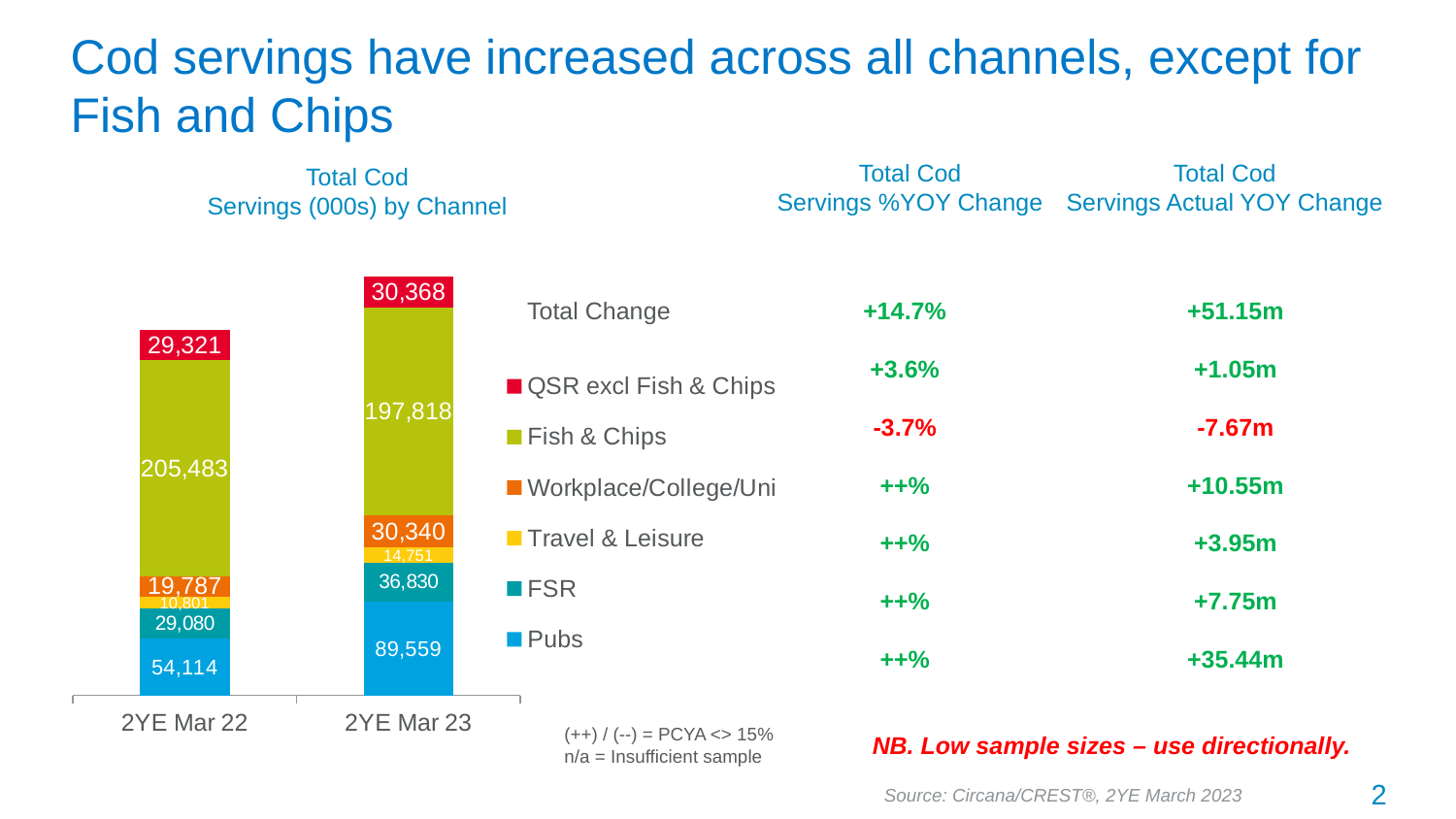
Which channel has the largest segment in the 2YE Mar 23 bar? Fish & Chips What is the value for Workplace/College/Uni in 2YE Mar 23? 30,340 How many series does the chart legend list? 6 Which channel has the smallest segment in the 2YE Mar 22 bar? Travel & Leisure Which is larger: Fish & Chips in 2YE Mar 22 or Fish & Chips in 2YE Mar 23? 2YE Mar 22 What is the value for Pubs in 2YE Mar 23? 89,559 How many bars (periods) are plotted on the chart? 2 What is the difference between the Pubs values for 2YE Mar 23 and 2YE Mar 22? 35,445 What is the value for FSR in 2YE Mar 22? 29,080 What type of chart is shown on the slide? Stacked bar chart What is the total of the 2YE Mar 23 stacked bar? 399,666 What is the value for Fish & Chips in 2YE Mar 22? 205,483